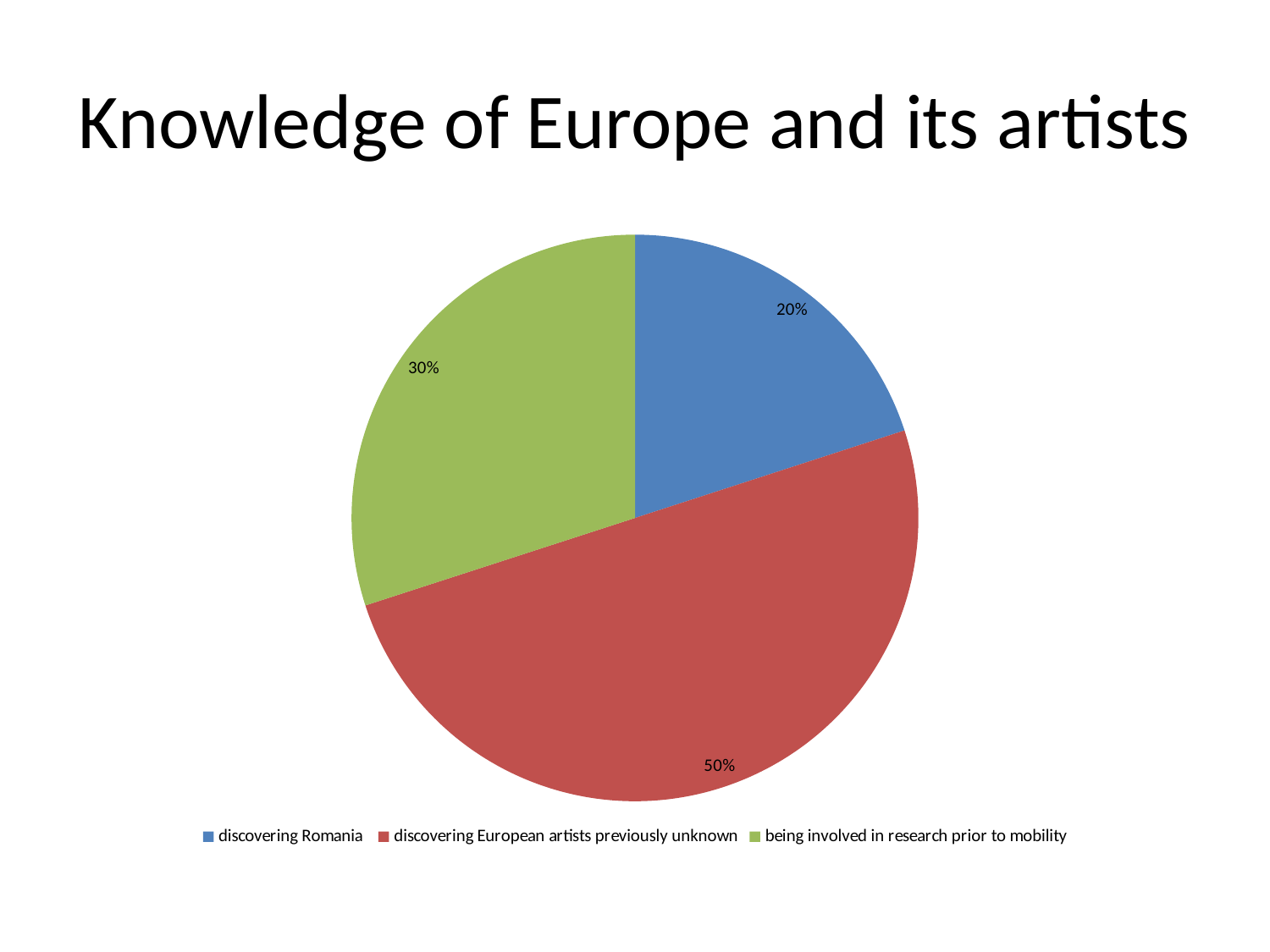
What share of the pie is 'discovering Romania'? 20% What kind of chart is shown on the slide? pie chart What is the title of the slide? Knowledge of Europe and its artists Which category has the smallest slice of the pie? discovering Romania How many categories does the pie chart show? 3 What is the difference in percentage points between 'being involved in research prior to mobility' and 'discovering Romania'? 10 What share of the pie is 'discovering European artists previously unknown'? 50% Which is larger: 'being involved in research prior to mobility' or 'discovering Romania'? being involved in research prior to mobility What share of the pie is 'being involved in research prior to mobility'? 30% Which colour represents 'discovering European artists previously unknown' in the pie chart? red What is the difference in percentage points between 'discovering European artists previously unknown' and 'discovering Romania'? 30 Which category has the largest slice of the pie? discovering European artists previously unknown